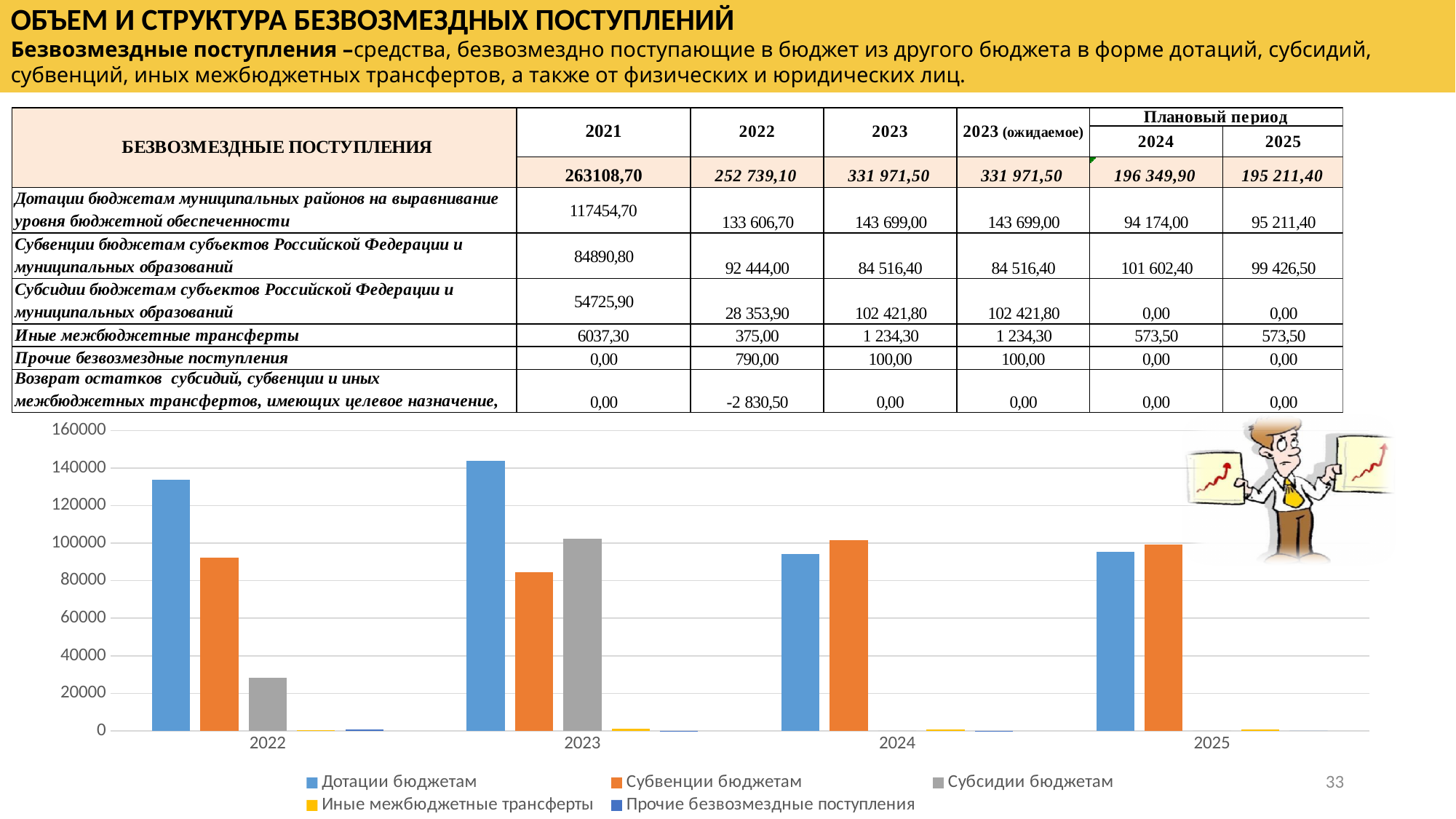
In which year is the bar for Дотации бюджетам the highest? 2023 Is the value for Субсидии бюджетам in 2023 greater or less than 80000? greater Is the value for Субсидии бюджетам in 2022 greater or less than 40000? less How many series does the legend of the bar chart list? 5 How many years are shown on the x axis of the bar chart? 4 Does the value for Субсидии бюджетам rise or fall from 2022 to 2023? rise What kind of chart is shown at the bottom of the slide? bar chart In 2024, which is larger: Субвенции бюджетам or Дотации бюджетам? Субвенции бюджетам Which series has the tallest bar in 2022? Дотации бюджетам In 2023, which is larger: Дотации бюджетам or Субсидии бюджетам? Дотации бюджетам Is the value for Дотации бюджетам in 2022 greater or less than 120000? greater What colour are the bars for Субвенции бюджетам in the chart? orange